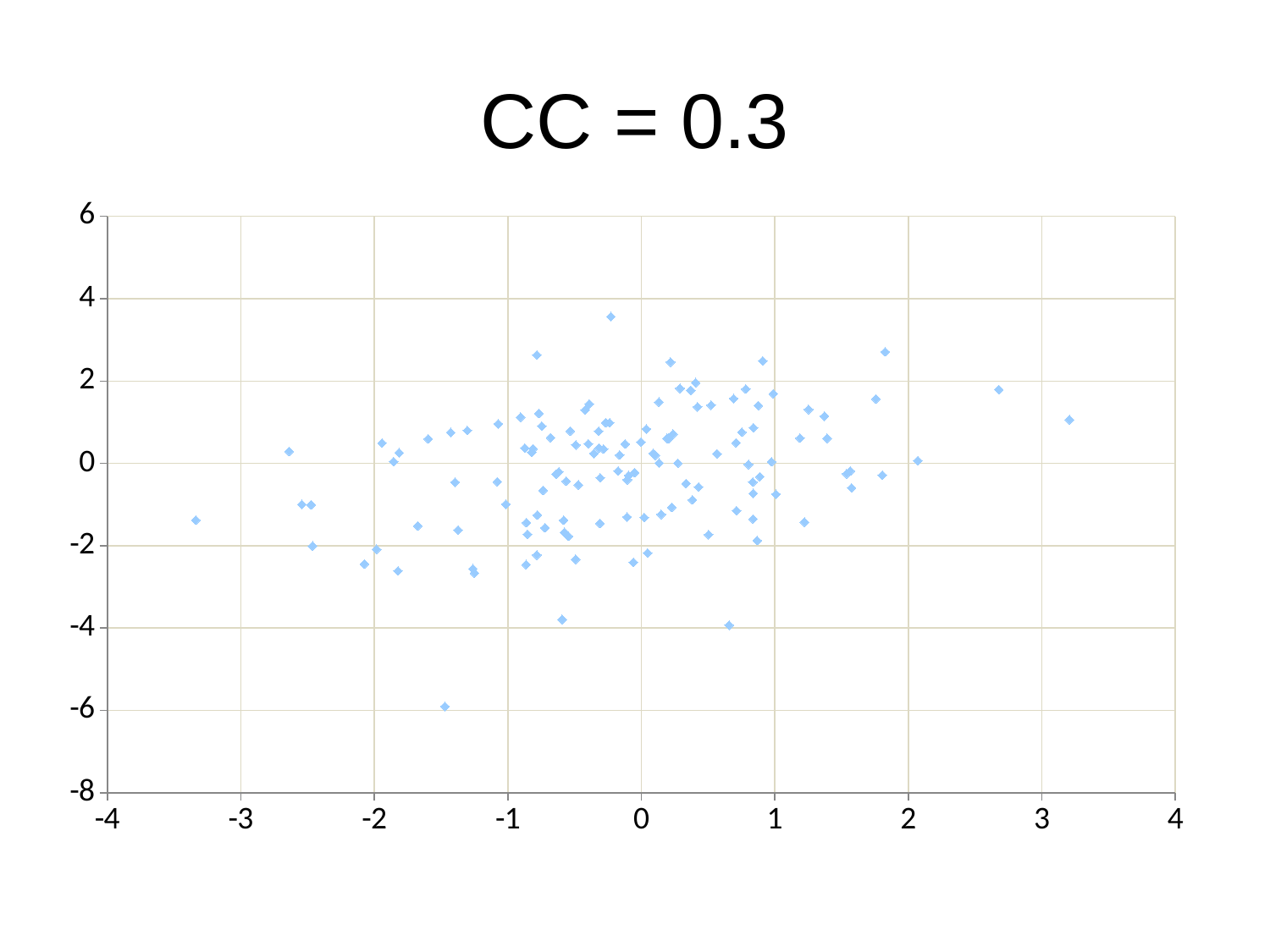
Is the x value of the leftmost plotted point greater or less than -3? less Is the x value of the lowest plotted point greater or less than -1? less Is the y value of the rightmost plotted point greater or less than 0? greater What kind of chart is shown on the slide? scatter chart What is the lowest value shown on the y axis? -8 What is the title of the chart? CC = 0.3 Do the plotted y values tend to rise or fall as x increases? rise